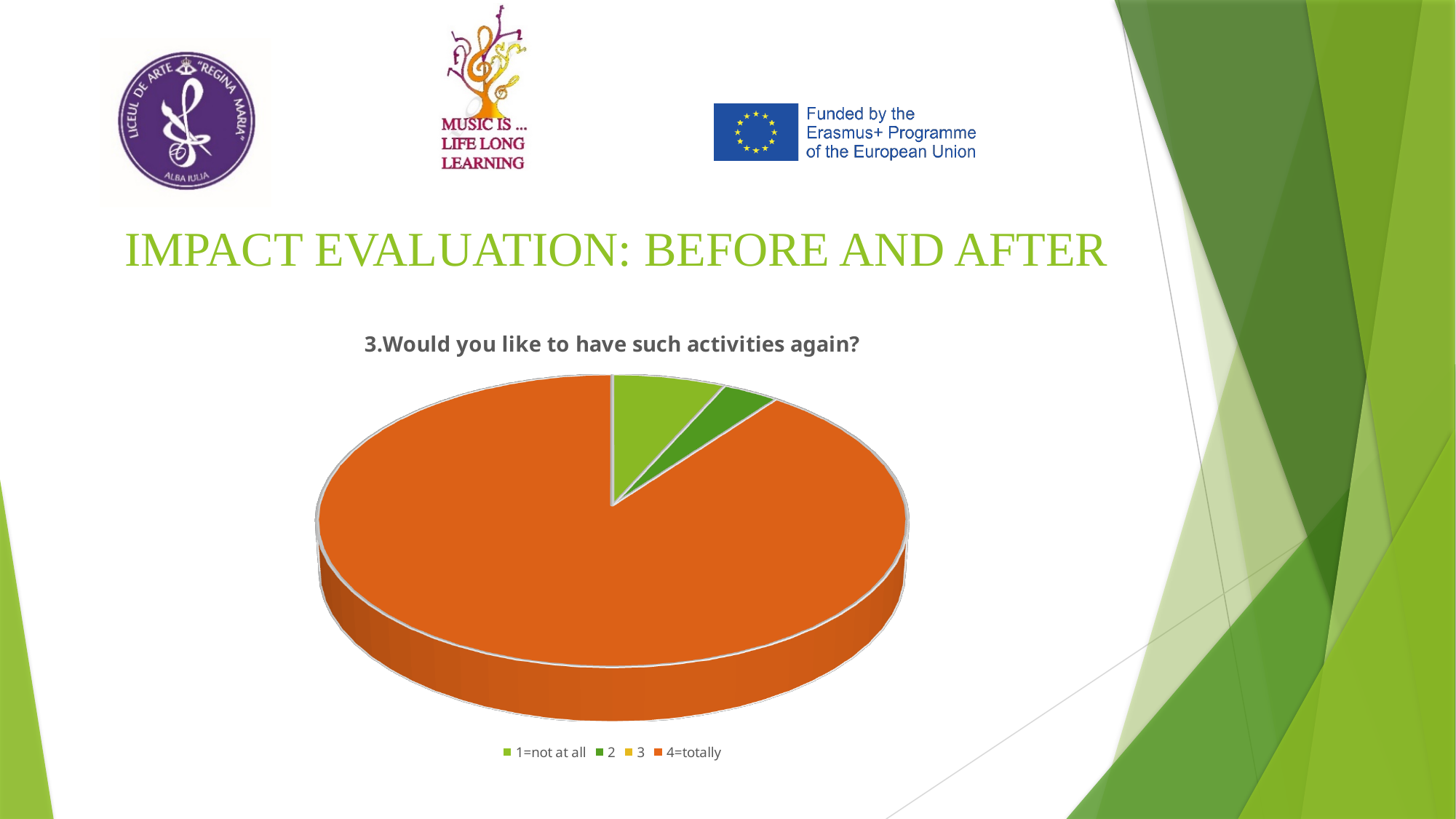
Which is larger in the pie, the slice for 4=totally or the slice for 1=not at all? 4=totally What is the title of the chart? 3.Would you like to have such activities again? Which response category takes up the largest share of the pie? 4=totally What kind of chart is shown on the slide? Pie chart How many entries does the chart legend list? 4 Does the 4=totally slice take up more or less than half of the pie? More What colour represents the 4=totally category in the chart? Orange Which is larger in the pie, the slice for 1=not at all or the slice for 2? 1=not at all